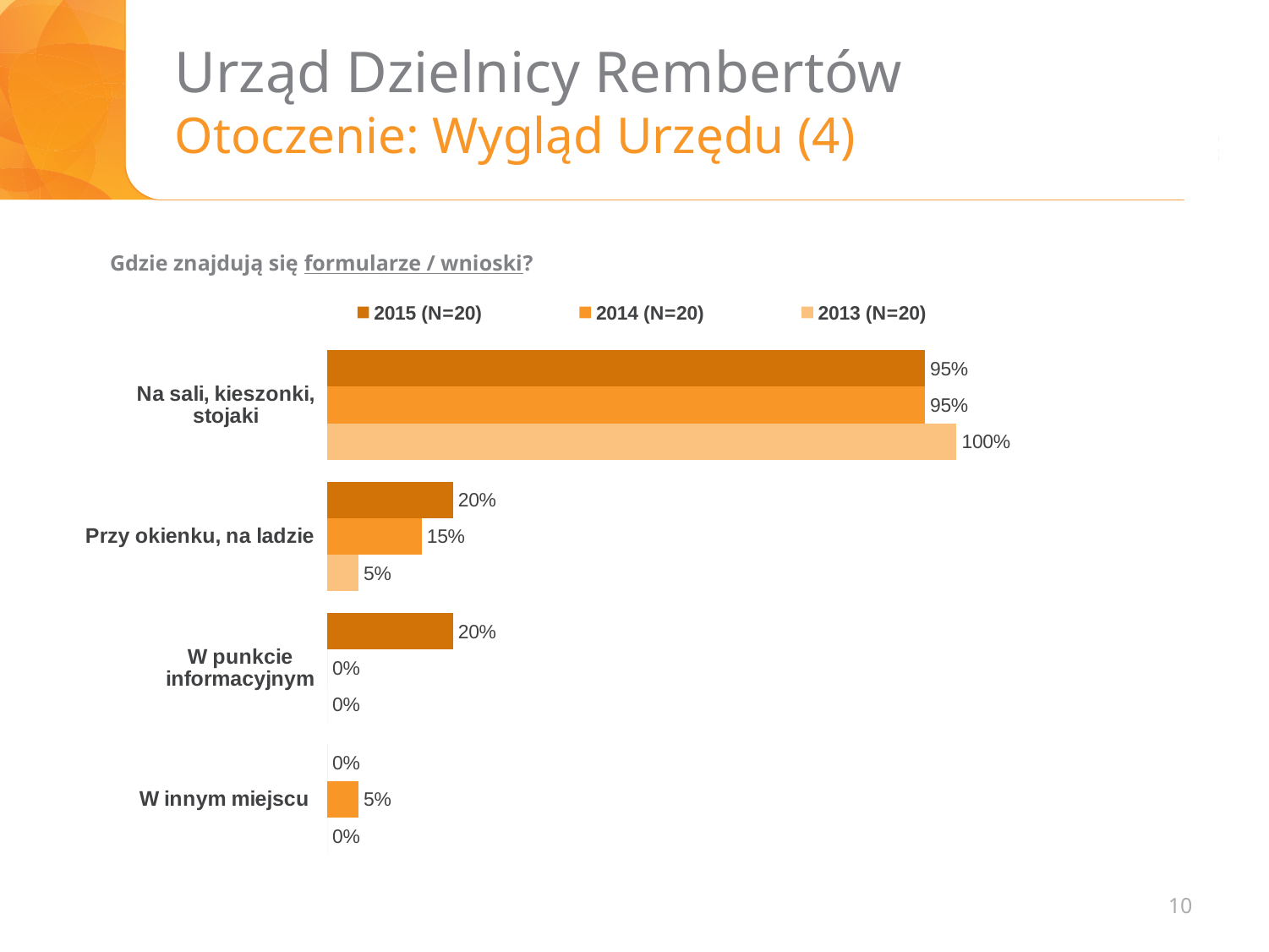
What is the value for "Na sali, kieszonki, stojaki" in the 2013 (N=20) series? 100% What is the value for "W innym miejscu" in the 2014 (N=20) series? 5% How many series does the legend list? 3 What question does the chart answer, as stated above it? Gdzie znajdują się formularze / wnioski? For "W punkcie informacyjnym", which series has the larger value: 2015 (N=20) or 2014 (N=20)? 2015 (N=20) What kind of chart is shown on the slide? Bar chart What is the value for "Przy okienku, na ladzie" in the 2014 (N=20) series? 15% What is the value for "Na sali, kieszonki, stojaki" in the 2015 (N=20) series? 95% Which category has the lowest value in the 2013 (N=20) series? W punkcie informacyjnym and W innym miejscu (both 0%) What is the difference between the 2015 (N=20) and 2013 (N=20) values for "Przy okienku, na ladzie"? 15% How many categories are shown on the chart? 4 Which category has the highest value in the 2015 (N=20) series? Na sali, kieszonki, stojaki